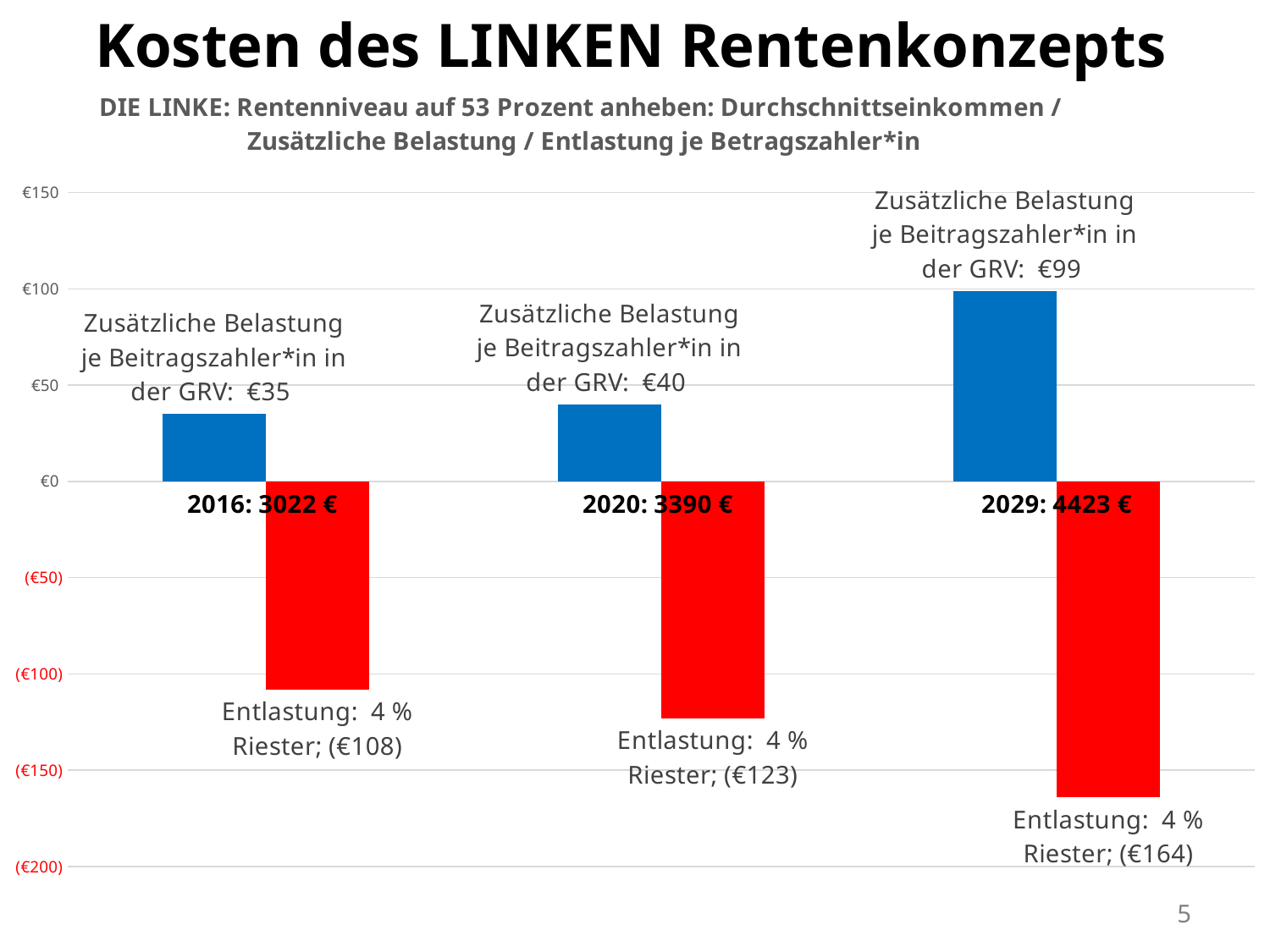
What is the Entlastung: 4 % Riester value shown for 2020: 3390 €? (€123) Which is larger, the Zusätzliche Belastung je Beitragszahler*in in der GRV for 2020: 3390 € or for 2016: 3022 €? 2020: 3390 € Do the Zusätzliche Belastung je Beitragszahler*in in der GRV values rise or fall from 2016: 3022 € to 2029: 4423 €? Rise What colour are the bars for the Entlastung: 4 % Riester values? Red What is the value of the Zusätzliche Belastung je Beitragszahler*in in der GRV for 2029: 4423 €? €99 What is the difference between the Zusätzliche Belastung je Beitragszahler*in in der GRV for 2029: 4423 € and for 2020: 3390 €? €59 What kind of chart is shown on the slide? Bar chart Which category has the highest Zusätzliche Belastung je Beitragszahler*in in der GRV? 2029: 4423 € Which category has the lowest Zusätzliche Belastung je Beitragszahler*in in der GRV? 2016: 3022 € How many categories are shown on the x axis of the chart? 3 What is the Entlastung: 4 % Riester value shown for 2029: 4423 €? (€164) What is the value of the Zusätzliche Belastung je Beitragszahler*in in der GRV for 2016: 3022 €? €35